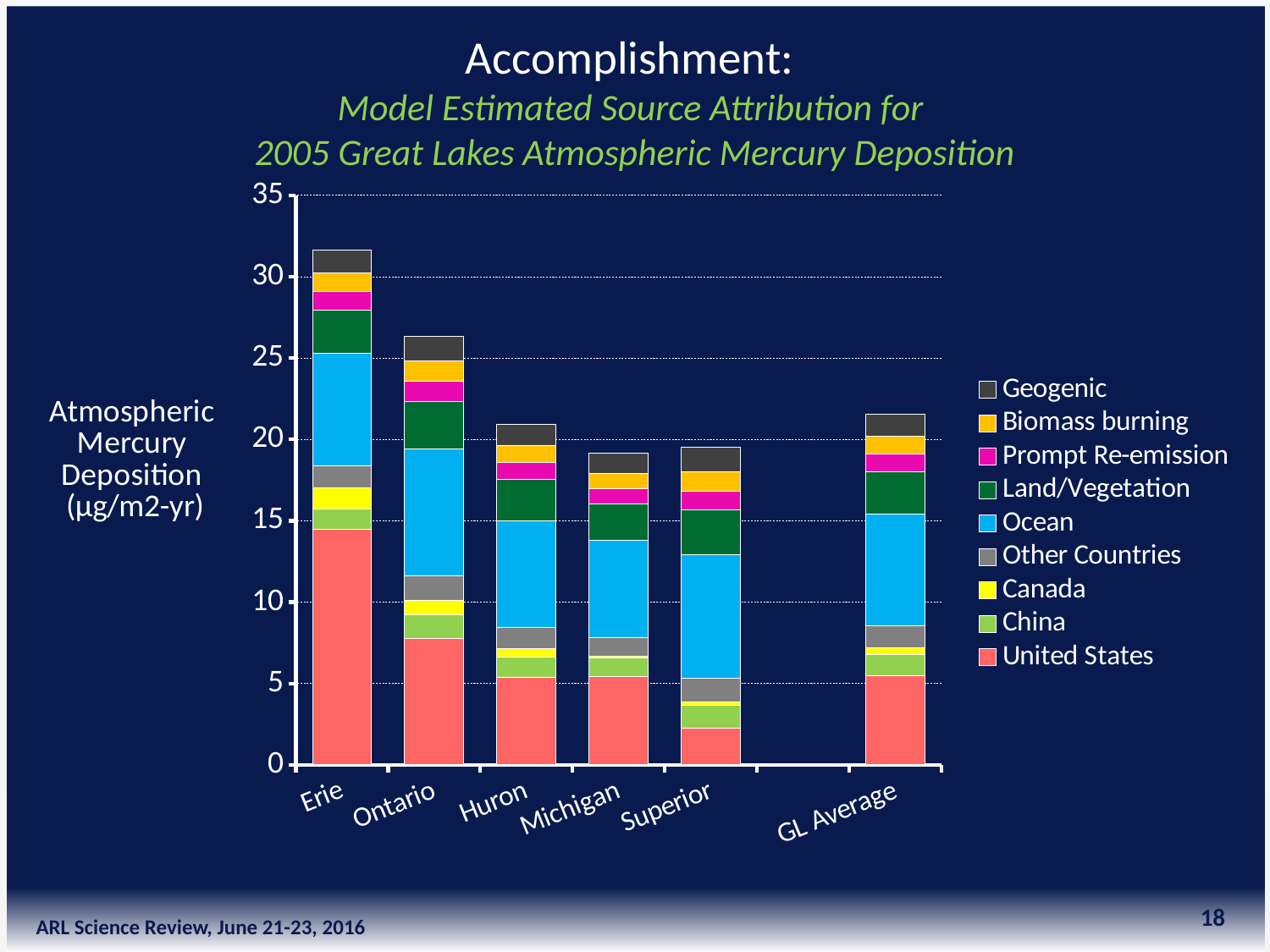
What kind of chart is shown on the slide? Stacked bar chart How many series does the chart's legend list? 9 Which series is listed at the bottom of the chart's legend? United States Is the total value for Erie greater or less than 30? greater How many categories are shown along the x axis of the chart? 6 Is the United States contribution for Superior greater or less than 5? less Which has a larger total deposition, Erie or Ontario? Erie Is the total value for Michigan greater or less than 20? less Which lake has the highest total atmospheric mercury deposition in the chart? Erie Which has a larger total deposition, Ontario or Huron? Ontario